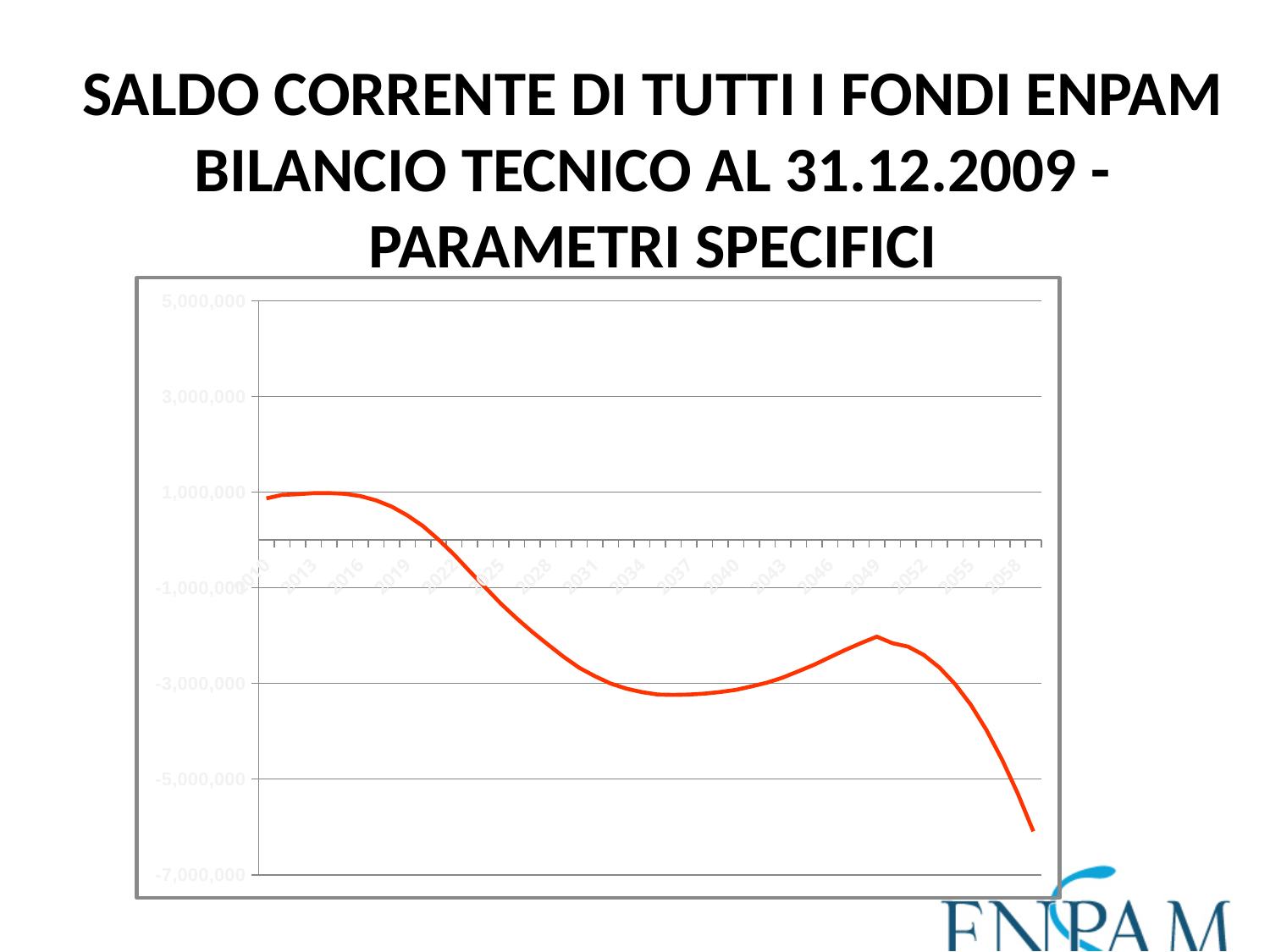
Is the value for 2019 greater or less than 0? greater Is the value for 2028 greater or less than -1,000,000? less What is the highest value shown on the vertical axis? 5,000,000 Is the value for 2058 greater or less than -5,000,000? less Does the line rise or fall between 2037 and 2049? rise What kind of chart is shown on the slide? line chart What colour is the plotted line? red Does the line rise or fall between 2049 and 2058? fall In which year does the line reach its lowest value? 2059 Overall, does the line rise or fall from 2010 to 2058? fall